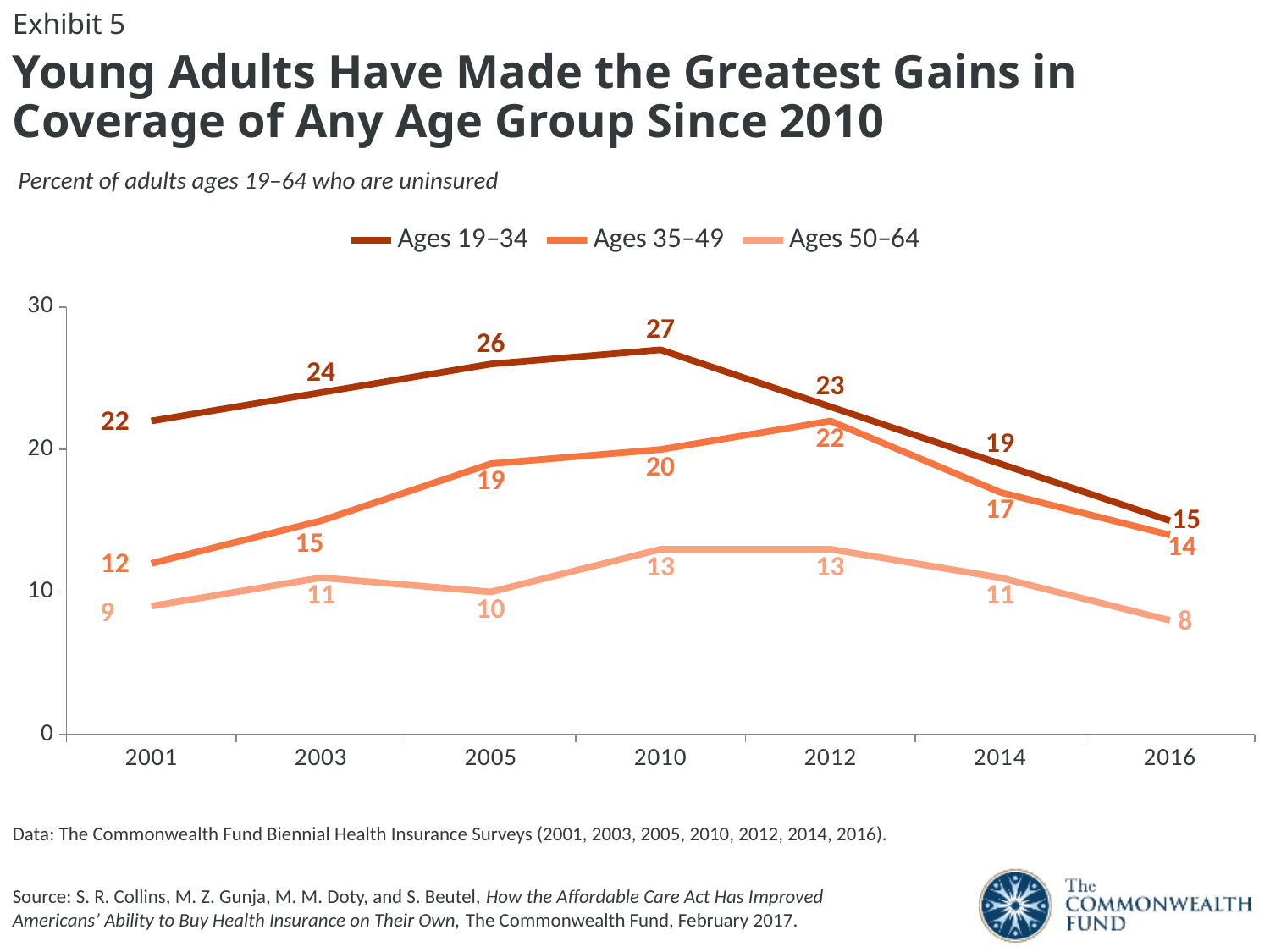
How many years are shown on the x axis? 7 How many series does the legend list? 3 What is the difference between the Ages 19–34 value in 2010 and in 2016? 12 What is the value for Ages 35–49 in 2012? 22 Does the Ages 19–34 series rise or fall from 2010 to 2016? Fall What kind of chart is shown on the slide? Line chart In which year is the Ages 19–34 series at its highest? 2010 What is the value for Ages 50–64 in 2016? 8 What does the subtitle say the chart measures? Percent of adults ages 19–64 who are uninsured Which is larger in 2001: the value for Ages 35–49 or the value for Ages 50–64? Ages 35–49 In which year is the Ages 50–64 series at its lowest? 2016 What is the value for Ages 19–34 in 2010? 27